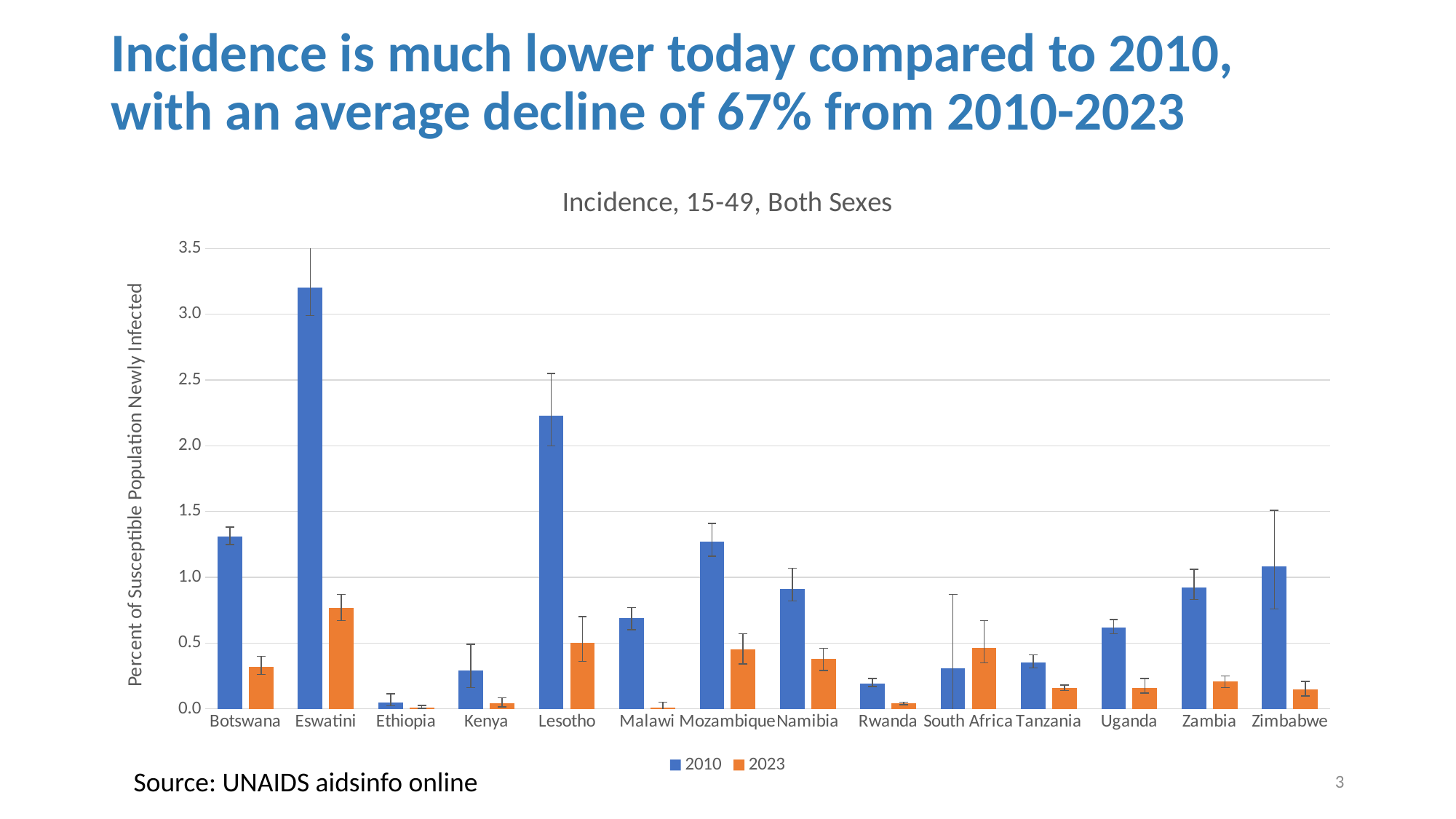
What type of chart is shown on the slide? Bar chart Which is larger, the 2010 value for Lesotho or the 2010 value for Mozambique? Lesotho Is the 2010 value for Lesotho greater or less than 2.0? greater Which country has the highest 2010 incidence value? Eswatini Is the 2023 value for Eswatini greater or less than 0.5? greater Is the 2010 value for Eswatini greater or less than 3.0? greater Which country has the lowest 2010 incidence value? Ethiopia How many countries are shown on the x axis of the chart? 14 How many series does the legend list? 2 Which country has the highest 2023 incidence value? Eswatini Which is larger, the 2023 value for Botswana or the 2023 value for Zambia? Botswana What is the title of the chart? Incidence, 15-49, Both Sexes